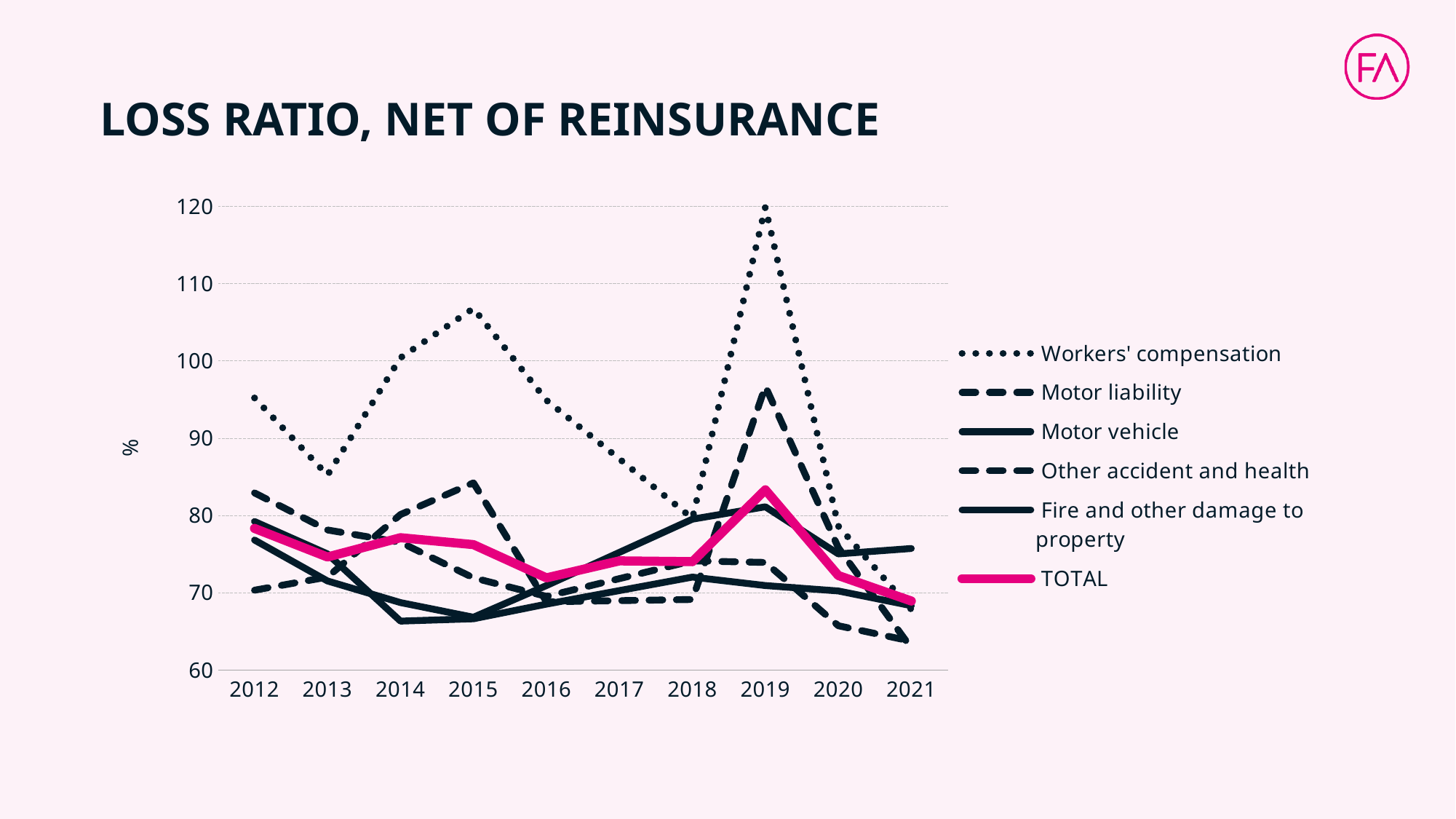
In 2019, which is larger: Workers' compensation or Motor liability? Workers' compensation Which series is drawn in pink? TOTAL What kind of chart is shown on the slide? line chart Is the value for Workers' compensation in 2019 greater or less than 110? greater Is the value for Workers' compensation in 2013 greater or less than 90? less Is the value for Motor liability in 2015 greater or less than 80? greater How many years are shown on the x axis? 10 Does the TOTAL line rise or fall from 2019 to 2021? fall How many series does the legend list? 6 In which year is the Workers' compensation loss ratio lowest? 2021 In which year is the Workers' compensation loss ratio highest? 2019